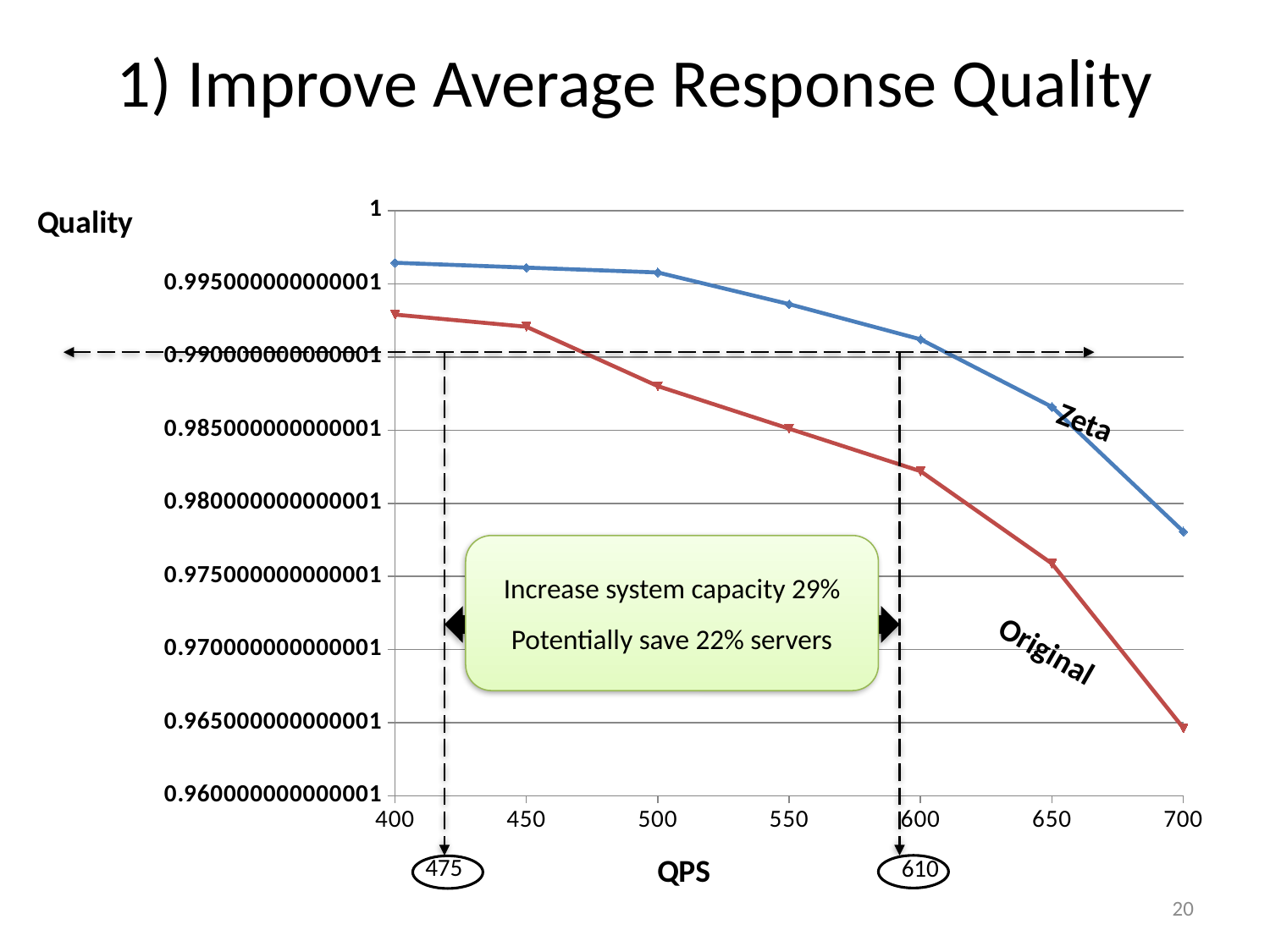
What two QPS values are circled below the x axis? 475 and 610 Is the quality of Zeta at 700 QPS greater or less than 0.98? less At which QPS value does the Original line reach its lowest quality? 700 Which line has the higher quality at 700 QPS, Zeta or Original? Zeta What is the label of the x axis? QPS How many lines (series) are plotted on the chart? 2 How many data points does the Zeta line have? 7 Is the quality of Zeta at 400 QPS greater or less than 0.995? greater What kind of chart is shown on the slide? line chart At which QPS value does the Zeta line reach its highest quality? 400 Is the quality of Original at 550 QPS greater or less than 0.99? less Does the quality of the Original line rise or fall as QPS increases? fall